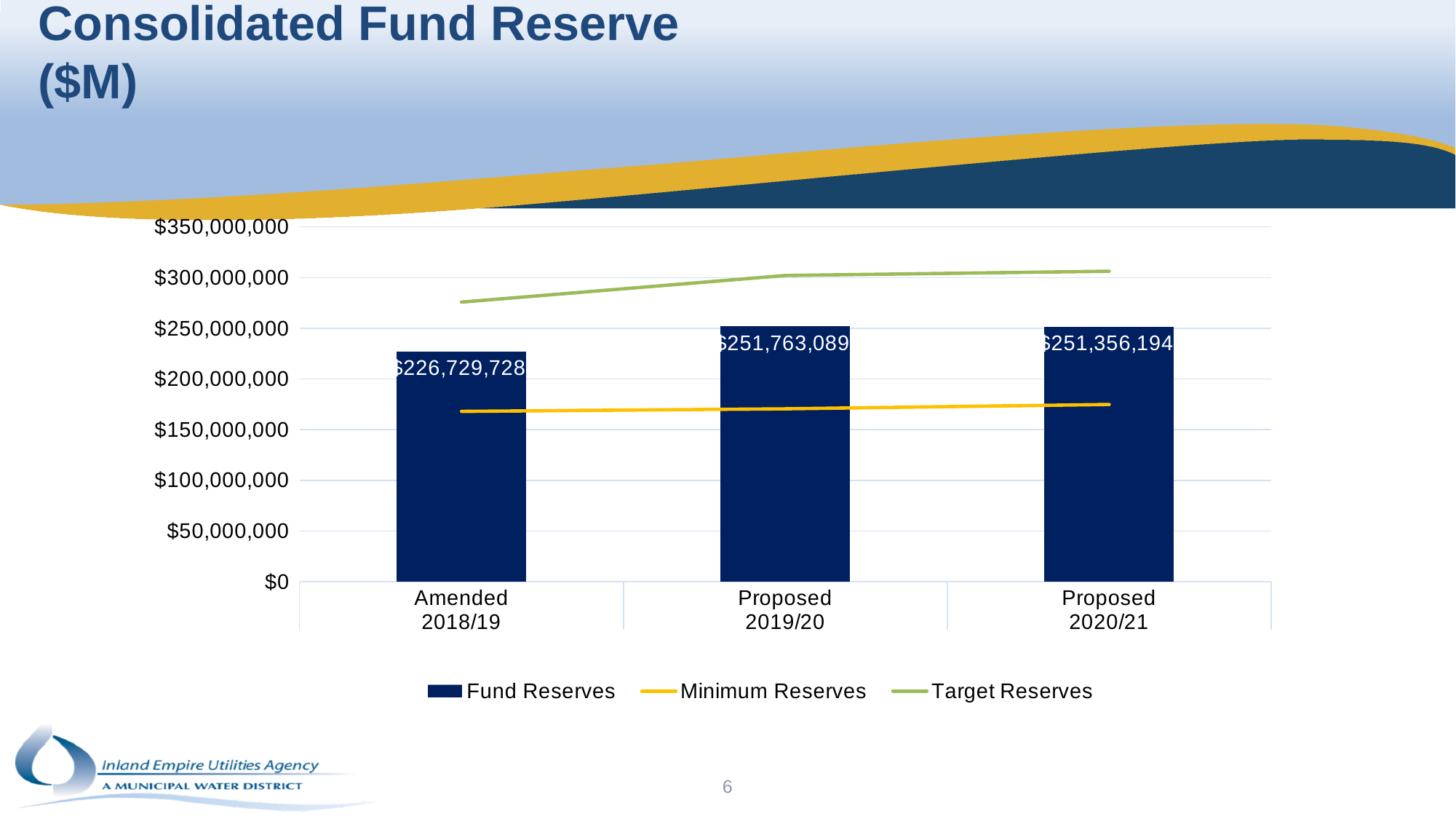
Which period has the highest Fund Reserves? Proposed 2019/20 What is the Fund Reserves value for Proposed 2019/20? $251,763,089 Is the Minimum Reserves value for Proposed 2020/21 greater or less than $200,000,000? less Is the Target Reserves value for Amended 2018/19 greater or less than $250,000,000? greater What is the difference in Fund Reserves between Proposed 2019/20 and Amended 2018/19? $25,033,361 What is the Fund Reserves value for Proposed 2020/21? $251,356,194 How many series does the legend list? 3 How many periods are shown on the x axis? 3 Which is larger, the Fund Reserves for Proposed 2019/20 or for Proposed 2020/21? Proposed 2019/20 Which period has the lowest Fund Reserves? Amended 2018/19 Does the Target Reserves line rise or fall from Amended 2018/19 to Proposed 2020/21? rise What is the Fund Reserves value for Amended 2018/19? $226,729,728